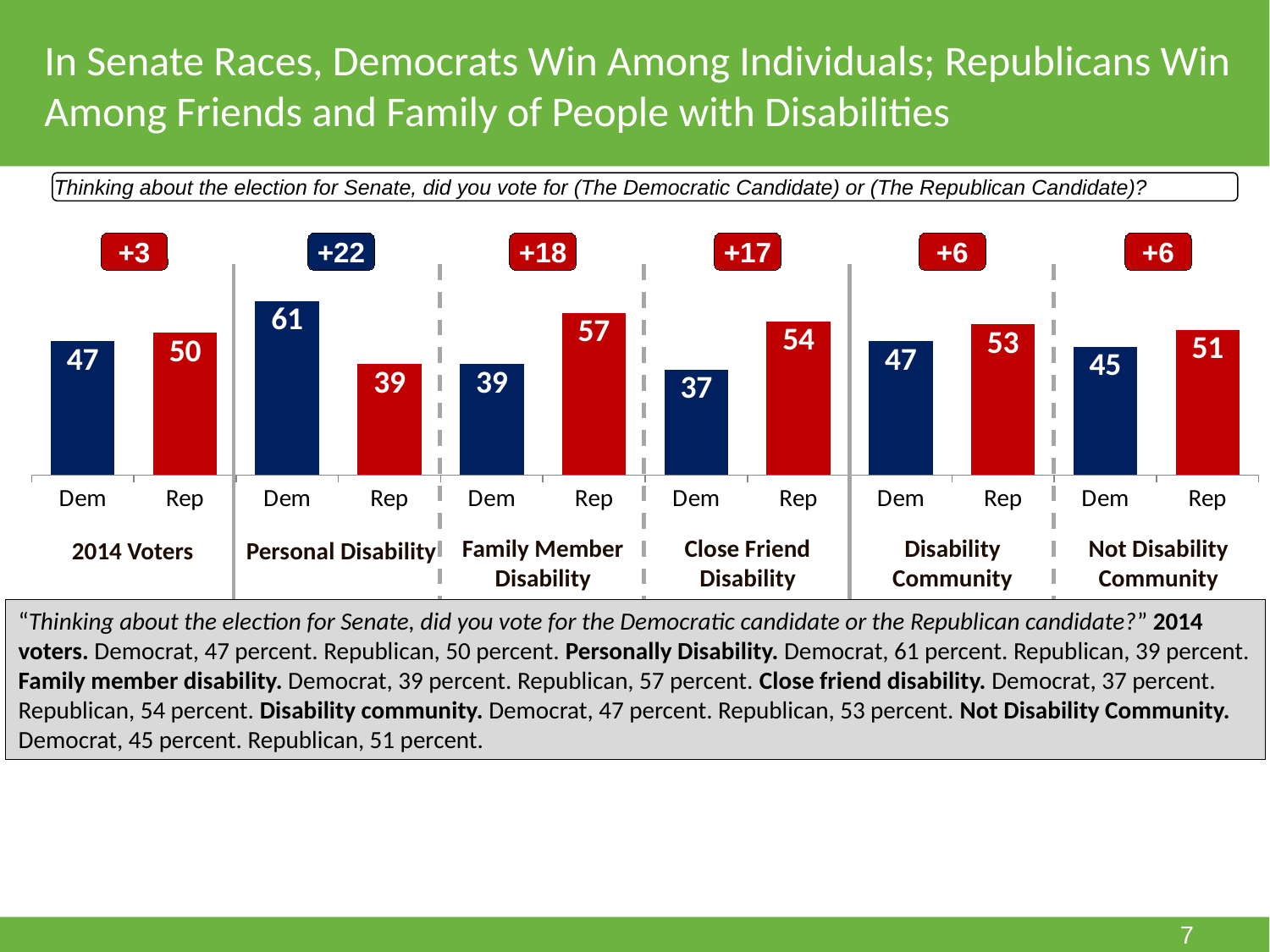
What is the value for Dem in the Personal Disability group? 61 Which bar has the lowest value on the chart? Dem, Close Friend Disability Which bar has the highest value on the chart? Dem, Personal Disability What kind of chart is shown on the slide? Bar chart What is the value for Rep among 2014 Voters? 50 What margin label is shown above the Family Member Disability group? +18 What is the value for Dem in the Close Friend Disability group? 37 How many groups of voters are shown on the chart? 6 What is the value for Rep in the Family Member Disability group? 57 In the Not Disability Community group, which is larger, Dem or Rep? Rep What is the difference between Rep and Dem in the Disability Community group? 6 What is the difference between Dem and Rep in the Personal Disability group? 22